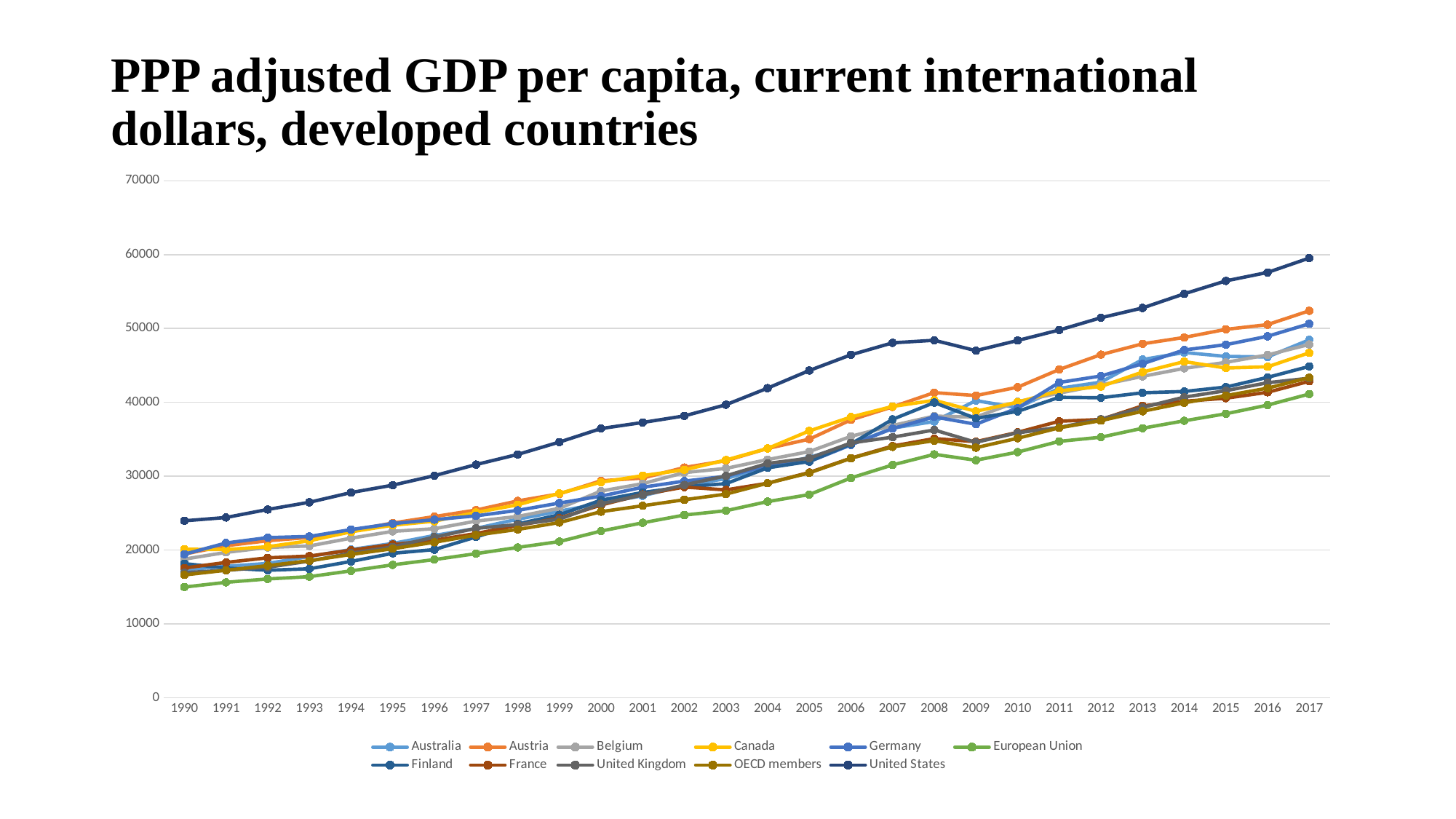
Which series has the lowest value in 2017? European Union What kind of chart is shown on the slide? line chart Is the value for Finland in 2017 greater or less than 40000? greater What is the title of the chart? PPP adjusted GDP per capita, current international dollars, developed countries Is the value for European Union in 1990 greater or less than 20000? less Between 2008 and 2009, does the value for United States rise or fall? fall How many years are shown along the x axis? 28 Is the value for United States in 2017 greater or less than 50000? greater Which is larger in 2017, the value for Austria or the value for European Union? Austria Which series has the highest value in 2017? United States How many series does the legend list? 11